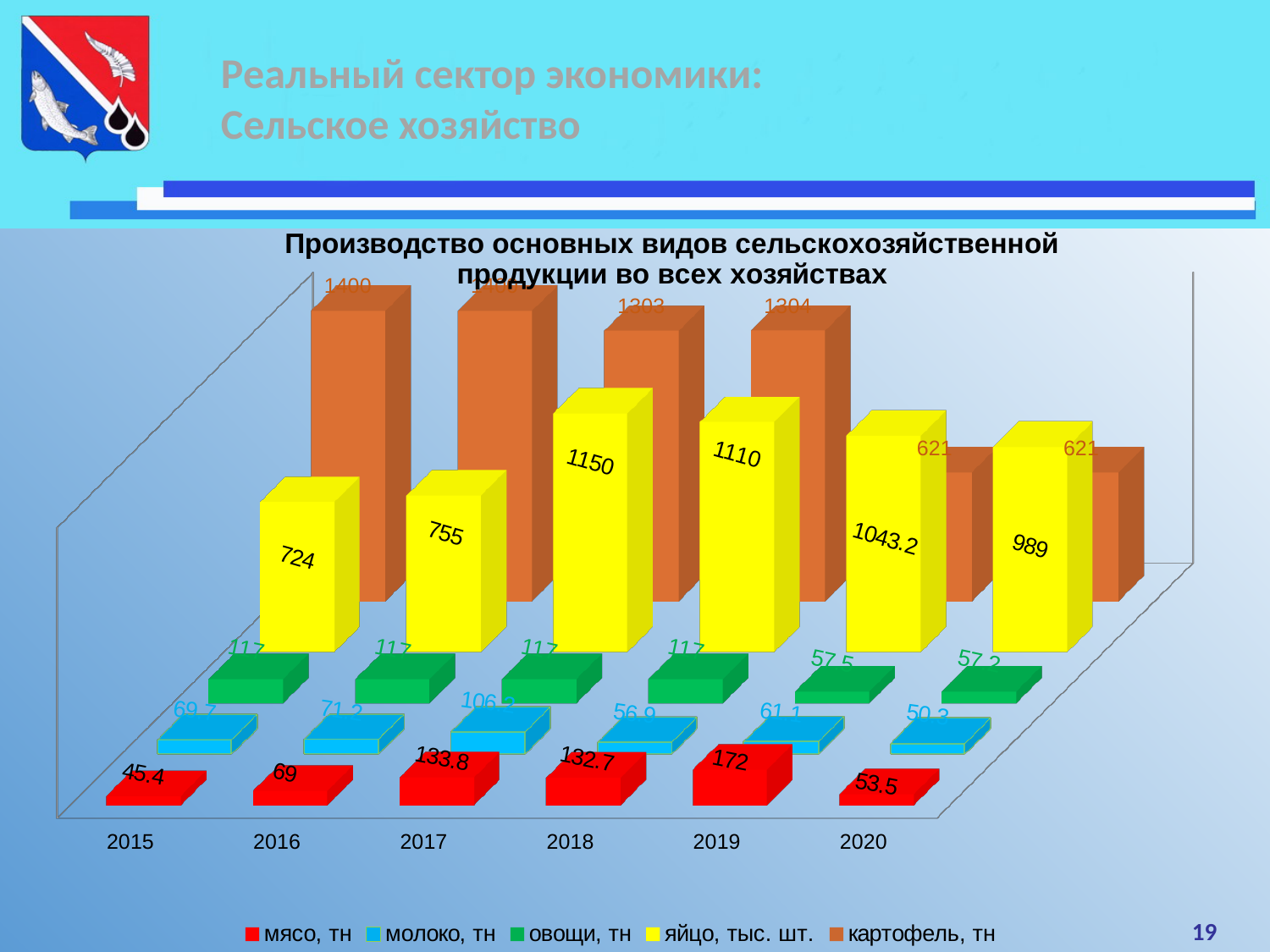
What kind of chart is shown on the slide? Bar chart What is the value for яйцо, тыс. шт. in 2017? 1150 Which colour represents картофель, тн in the legend? Orange In which year is яйцо, тыс. шт. lowest? 2015 What is the value for яйцо, тыс. шт. in 2020? 989 How many series does the legend list? 5 What is the value for овощи, тн in 2019? 57.5 What is the value for мясо, тн in 2019? 172 What is the difference between яйцо, тыс. шт. in 2017 and in 2018? 40 How many years are shown on the x axis? 6 Which is larger, яйцо, тыс. шт. in 2019 or in 2020? 2019 In which year is мясо, тн highest? 2019